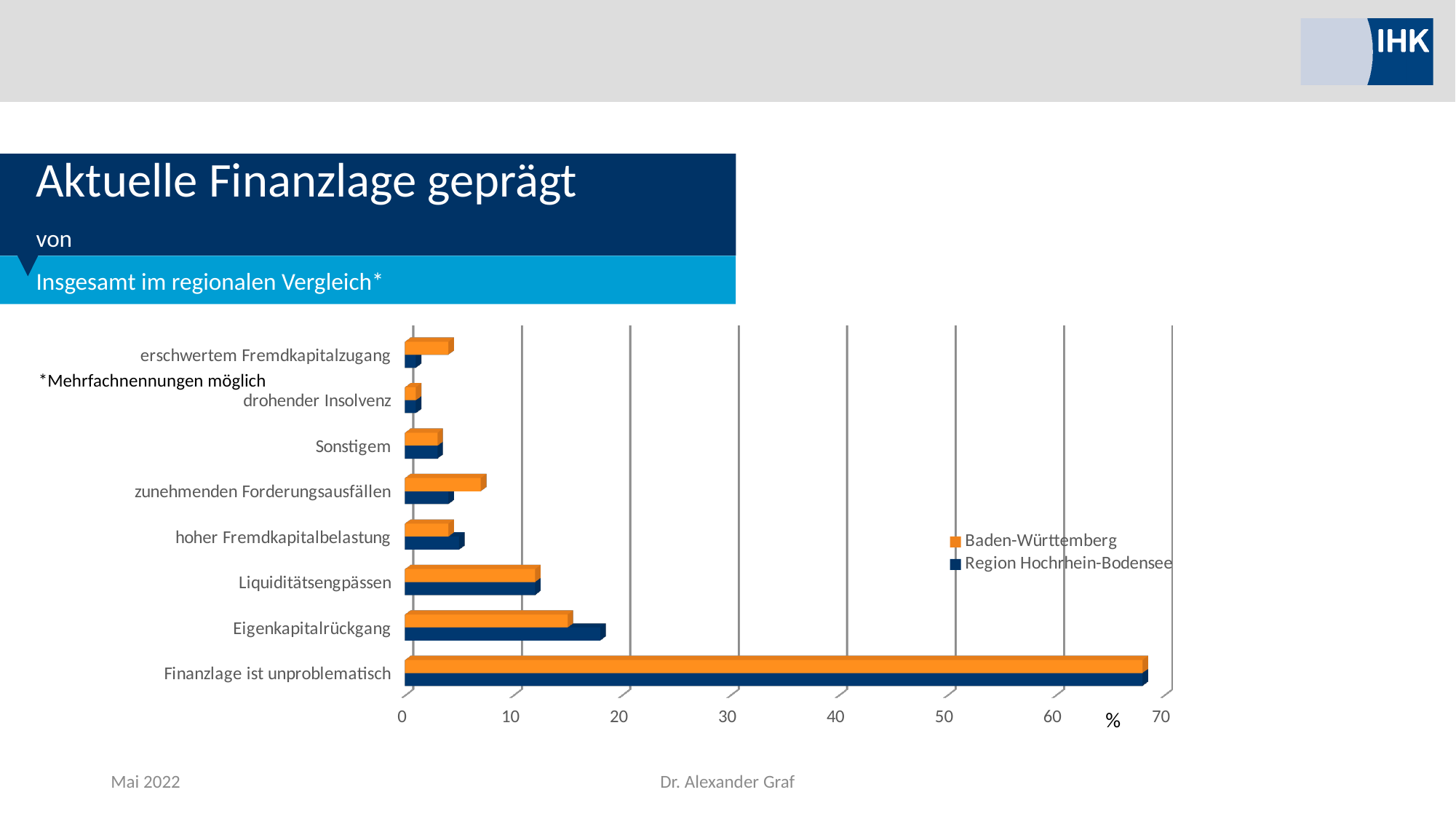
Which category has the highest value for Region Hochrhein-Bodensee? Finanzlage ist unproblematisch Is the value for Liquiditätsengpässen for Baden-Württemberg greater or less than 10? greater Which category has the highest value for Baden-Württemberg? Finanzlage ist unproblematisch Is the value for Eigenkapitalrückgang for Region Hochrhein-Bodensee greater or less than 20? less How many series does the legend list? 2 For zunehmenden Forderungsausfällen, which series has the larger value, Baden-Württemberg or Region Hochrhein-Bodensee? Baden-Württemberg What kind of chart is shown on the slide? bar chart How many categories are plotted on the chart? 8 Is the value for Finanzlage ist unproblematisch for Baden-Württemberg greater or less than 60? greater Which colour represents Baden-Württemberg in the legend? orange Which category has the lowest value for Baden-Württemberg? drohender Insolvenz For Eigenkapitalrückgang, which series has the larger value, Baden-Württemberg or Region Hochrhein-Bodensee? Region Hochrhein-Bodensee